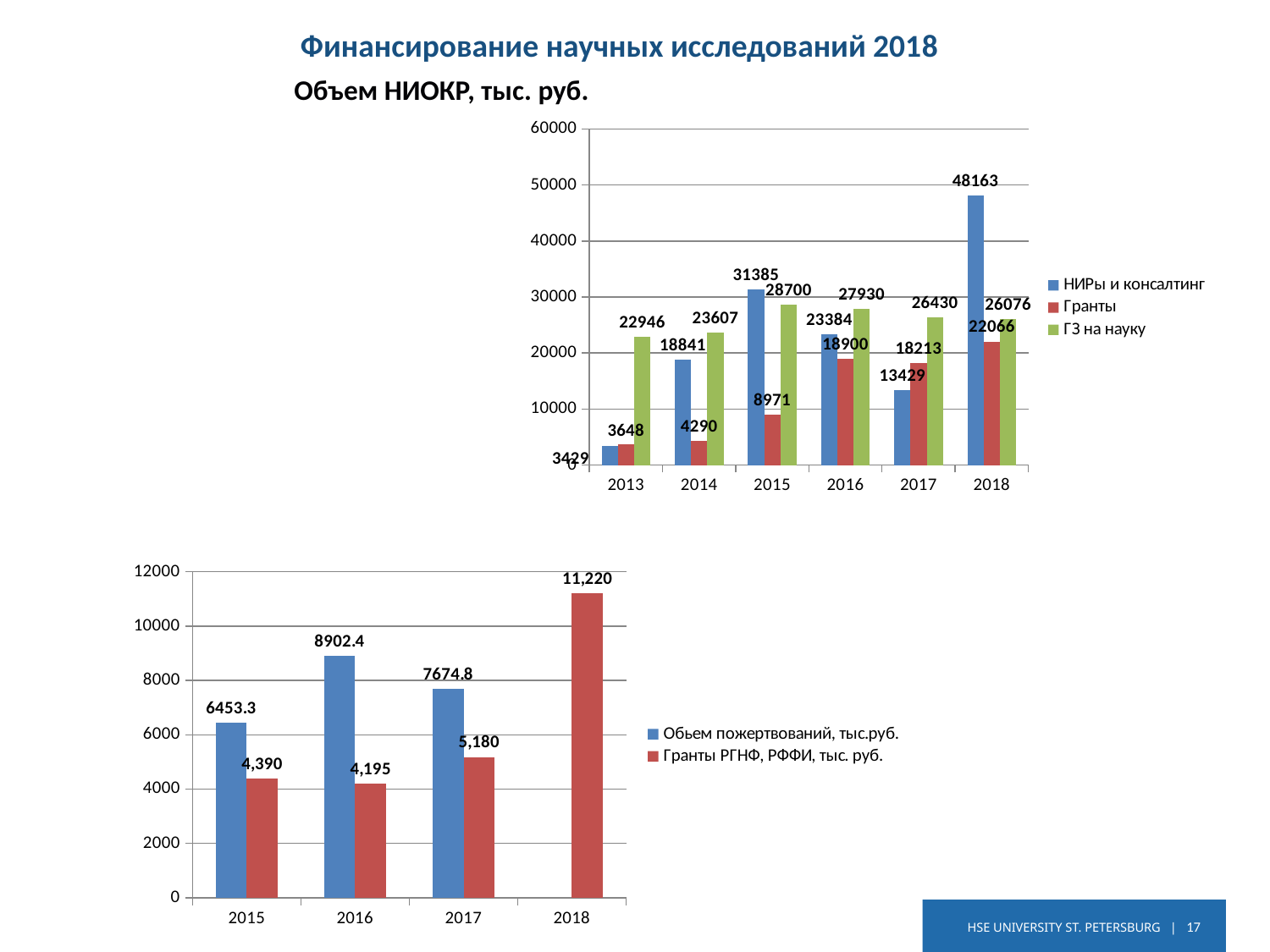
In the top chart 'Объем НИОКР, тыс. руб.', what is the value of 'ГЗ на науку' for 2014? 23607 In the top chart 'Объем НИОКР, тыс. руб.', how many series does the legend list? 3 In the bottom chart, what is the value of 'Гранты РГНФ, РФФИ, тыс. руб.' for 2018? 11,220 In the top chart 'Объем НИОКР, тыс. руб.', what is the value of 'Гранты' for 2015? 8971 In the top chart 'Объем НИОКР, тыс. руб.', how many years are shown on the x axis? 6 In the top chart 'Объем НИОКР, тыс. руб.', which year has the highest value for 'НИРы и консалтинг'? 2018 In the top chart 'Объем НИОКР, тыс. руб.', what is the value of 'НИРы и консалтинг' for 2018? 48163 What kind of chart is the bottom chart? Bar chart In the top chart 'Объем НИОКР, тыс. руб.', which year has the lowest value for 'Гранты'? 2013 In the top chart 'Объем НИОКР, тыс. руб.', what is the difference between 'ГЗ на науку' and 'Гранты' in 2016? 9030 In the bottom chart, what is the value of 'Обьем пожертвований, тыс.руб.' for 2016? 8902.4 In the bottom chart, which is larger in 2017: 'Обьем пожертвований, тыс.руб.' or 'Гранты РГНФ, РФФИ, тыс. руб.'? Обьем пожертвований, тыс.руб.